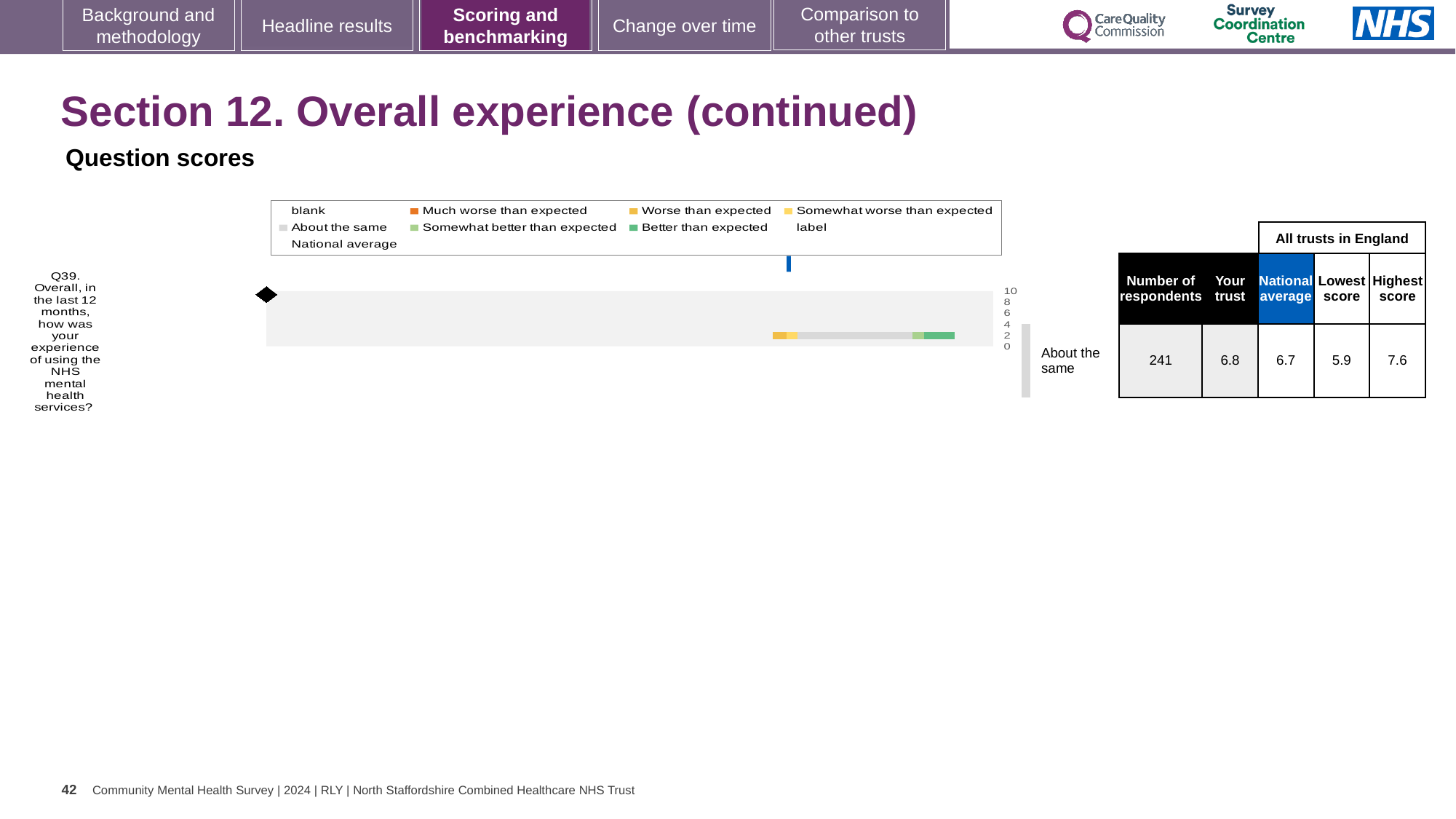
What kind of chart is used to show the Q39 score? Bar chart What is the difference between the highest score and the lowest score for Q39? 1.7 Is the trust's score for Q39 greater or less than 6? greater By how much does the trust's score for Q39 exceed the national average? 0.1 How many questions are plotted on this chart? 1 What is the highest score among all trusts in England for Q39? 7.6 What is the 'Your trust' score for Q39 (Overall, in the last 12 months, how was your experience of using the NHS mental health services?)? 6.8 How many respondents answered Q39? 241 What is the national average score shown for Q39? 6.7 What benchmark category is the trust's Q39 score placed in? About the same What is the lowest score among all trusts in England for Q39? 5.9 Which is higher for Q39: the trust's score or the national average? The trust's score (6.8)